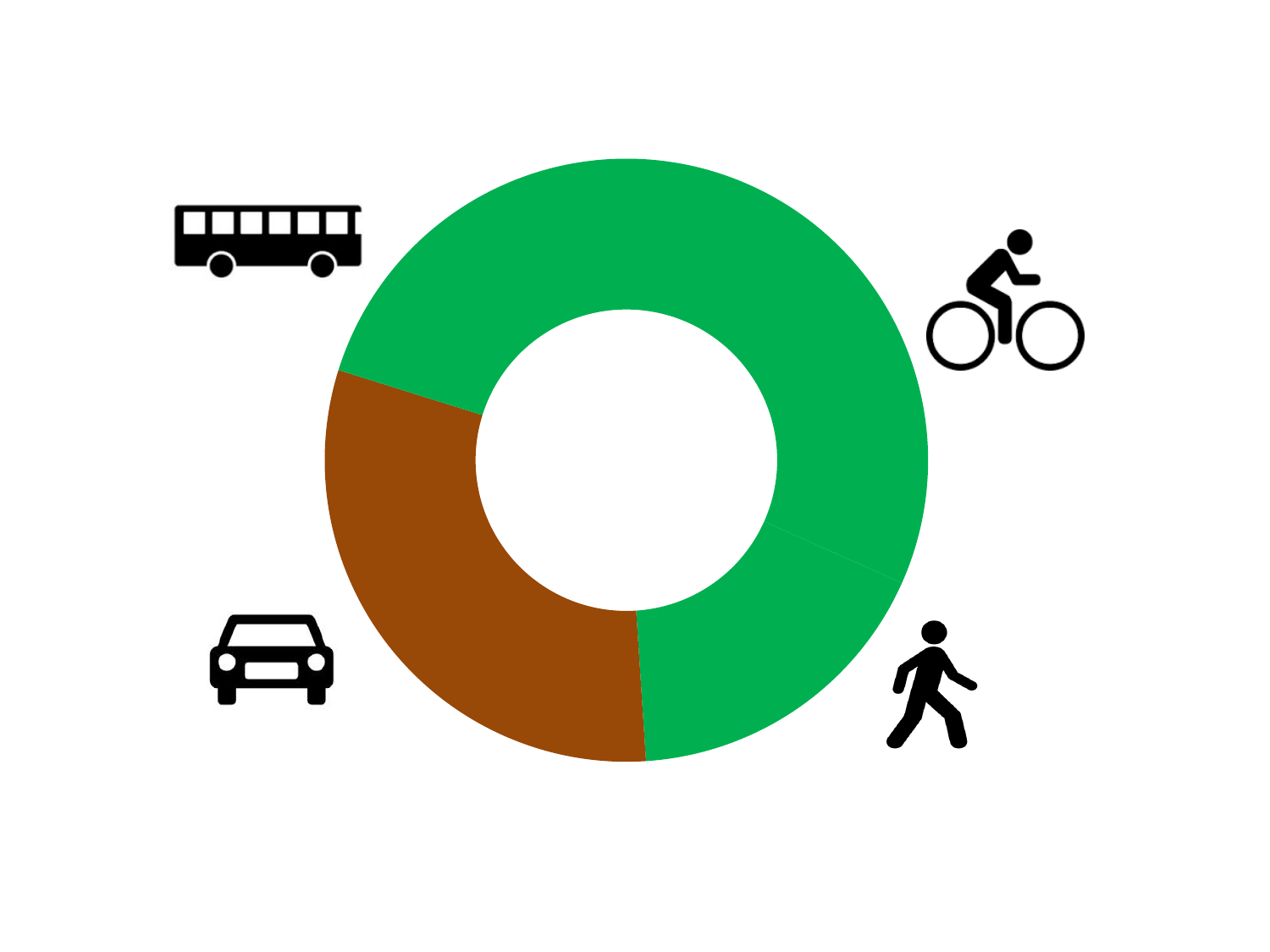
Which transport icons are placed around the doughnut chart? bus, bicycle, pedestrian, car Does the brown slice cover more or less than half of the doughnut chart? less How many distinct colours are used for the slices of the doughnut chart? 2 What kind of chart is shown on the slide? doughnut chart Is the brown slice of the doughnut chart larger or smaller than the green portion? smaller Which colour slice of the doughnut chart is the largest? green